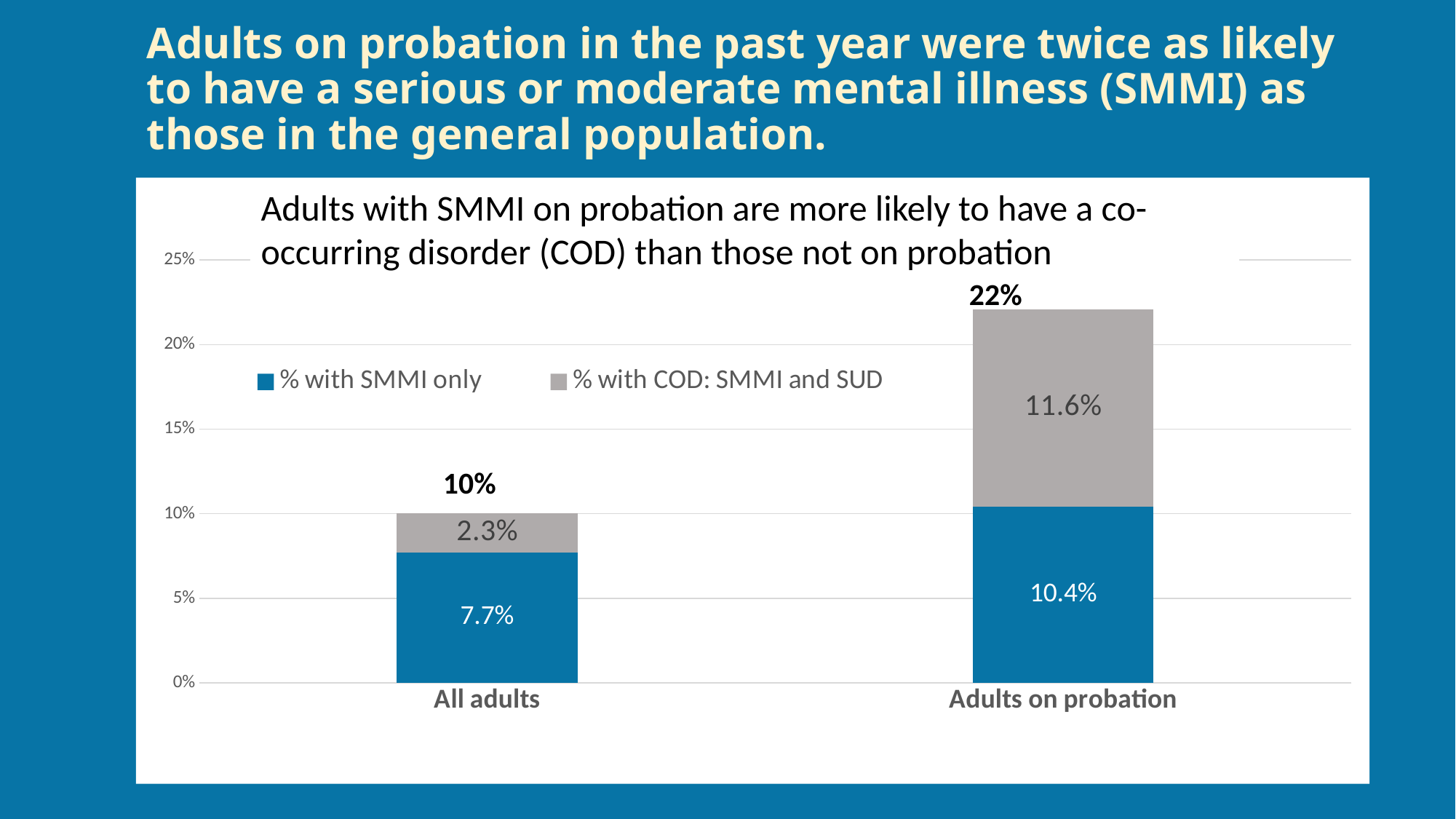
What is the value of '% with SMMI only' for All adults? 7.7% What is the value of '% with COD: SMMI and SUD' for Adults on probation? 11.6% What is the total labelled above the stacked bar for All adults? 10% Which category has the lower value for '% with SMMI only'? All adults What is the total labelled above the stacked bar for Adults on probation? 22% What kind of chart is shown on the slide? Stacked bar chart What is the difference between the '% with COD: SMMI and SUD' values for Adults on probation and All adults? 9.3% What is the value of '% with COD: SMMI and SUD' for All adults? 2.3% How many categories are shown on the x axis? 2 What is the value of '% with SMMI only' for Adults on probation? 10.4% How many series does the legend list? 2 Which category has the higher value for '% with COD: SMMI and SUD'? Adults on probation